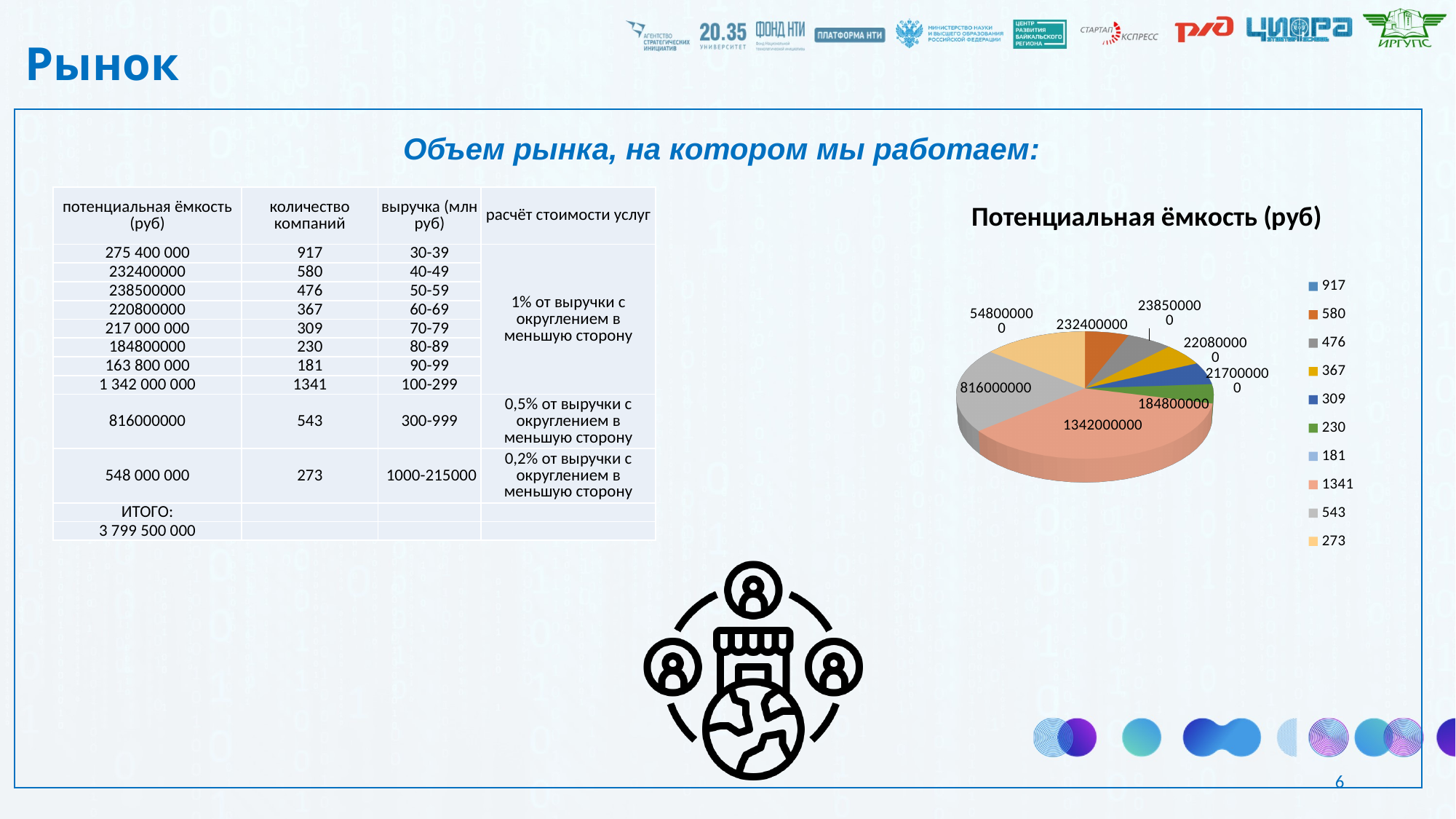
In the pie chart, what value is labelled for the slice corresponding to legend entry 230? 184800000 In the pie chart, what value is labelled for the slice corresponding to legend entry 580? 232400000 In the pie chart, what value is labelled for the slice corresponding to legend entry 543? 816000000 What kind of chart is shown on the slide? pie chart In the pie chart, what value is labelled for the slice corresponding to legend entry 1341? 1342000000 What is the title of the pie chart? Потенциальная ёмкость (руб) What is the difference between the values labelled for the 1341 slice and the 543 slice? 526000000 In the pie chart, what value is labelled for the slice corresponding to legend entry 273? 548000000 Which slice is larger in the pie chart: the one for legend entry 1341 or the one for legend entry 580? 1341 How many entries does the legend of the pie chart list? 10 Which legend entry corresponds to the largest slice of the pie chart? 1341 Which slice is larger in the pie chart: the one for legend entry 543 or the one for legend entry 273? 543